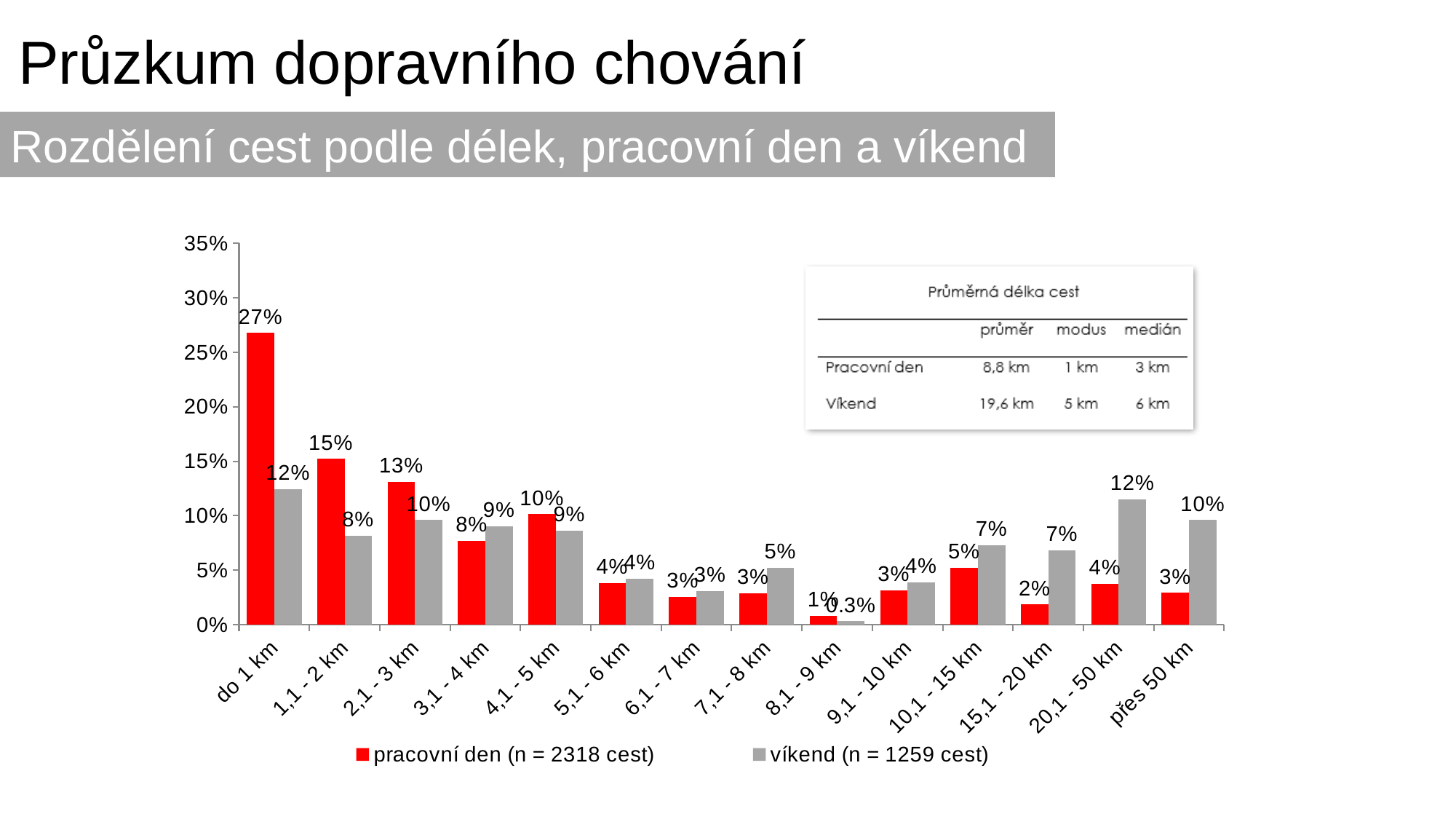
Which colour represents the 'víkend' series? grey Is the value for 'pracovní den' in the '1,1 - 2 km' category greater or less than 10%? greater In the '15,1 - 20 km' category, which series has the larger value, 'pracovní den' or 'víkend'? víkend What is the value for 'pracovní den' in the 'do 1 km' category? 27% What is the value for 'víkend' in the '8,1 - 9 km' category? 0.3% Which category has the highest value for 'pracovní den'? do 1 km How many series does the legend list? 2 What is the value for 'víkend' in the '20,1 - 50 km' category? 12% What is the difference between the 'pracovní den' and 'víkend' values in the 'do 1 km' category? 15% How many distance categories are shown on the x axis? 14 What kind of chart is shown on the slide? bar chart Which category has the lowest value for 'víkend'? 8,1 - 9 km